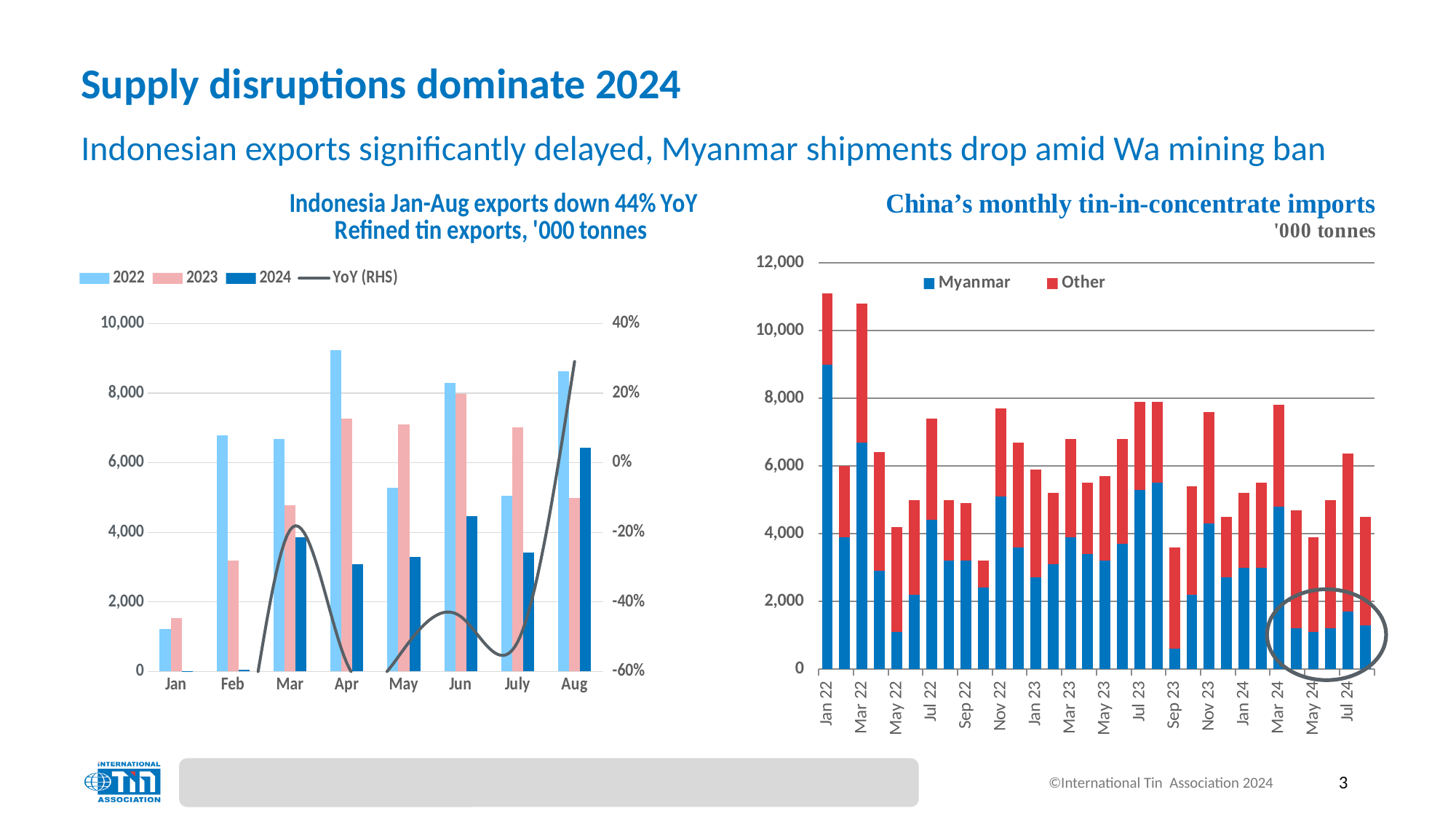
In the 'Refined tin exports' chart on the left, which is larger for July: the 2022 value or the 2023 value? 2023 In the 'Refined tin exports' chart on the left, which month has the lowest 2022 value? Jan In the 'Refined tin exports' chart on the left, is the 2024 value for Aug greater or less than 6,000? greater In the 'Refined tin exports' chart on the left, which month has the highest 2024 value? Aug In the 'Refined tin exports' chart on the left, which month has the highest 2022 value? Apr How many months are shown on the x axis of the 'Refined tin exports' chart on the left? 8 How many entries does the legend of the 'Refined tin exports' chart on the left list? 4 In the 'China's monthly tin-in-concentrate imports' chart, which colour represents the 'Other' series? Red What kind of chart is the 'China's monthly tin-in-concentrate imports' chart? Stacked bar chart In the 'China's monthly tin-in-concentrate imports' chart, is the Myanmar value for Jan 22 greater or less than 8,000? greater In the 'China's monthly tin-in-concentrate imports' chart, is the total bar for Jan 22 greater or less than 10,000? greater How many series does the legend of the 'China's monthly tin-in-concentrate imports' chart list? 2